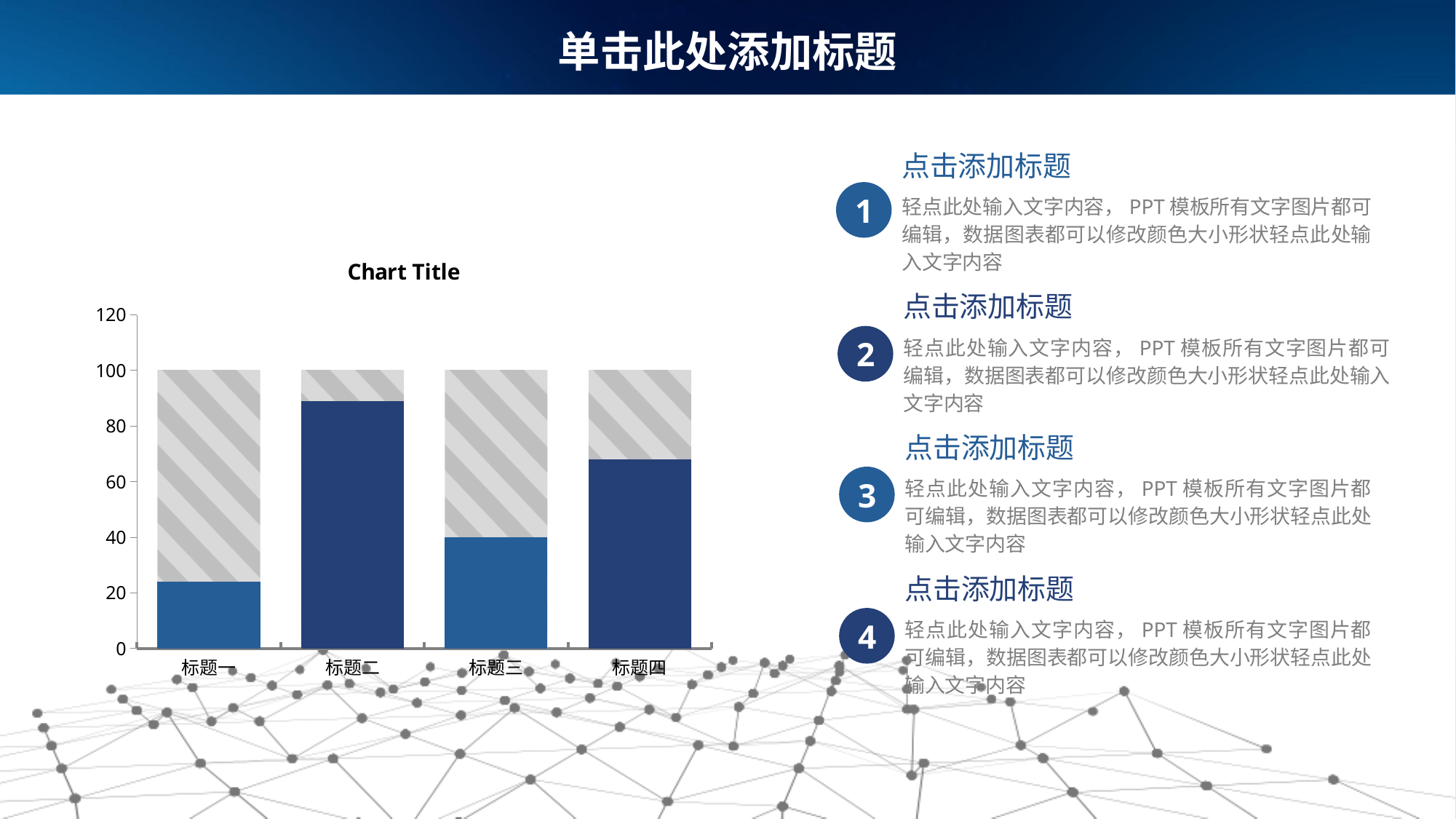
What kind of chart is shown on the slide? bar chart Which category has the lowest blue (lower) segment? 标题一 How many categories are shown on the x axis of the chart? 4 Is the blue segment for 标题三 greater or less than 60? less What is the highest value shown on the vertical axis? 120 Which has a larger blue segment, 标题二 or 标题四? 标题二 Is the blue segment for 标题四 greater or less than 60? greater Which category has the highest blue (lower) segment? 标题二 Is the blue segment for 标题一 greater or less than 40? less What is the total height of the stacked bar for 标题一? 100 What is the title of the chart? Chart Title